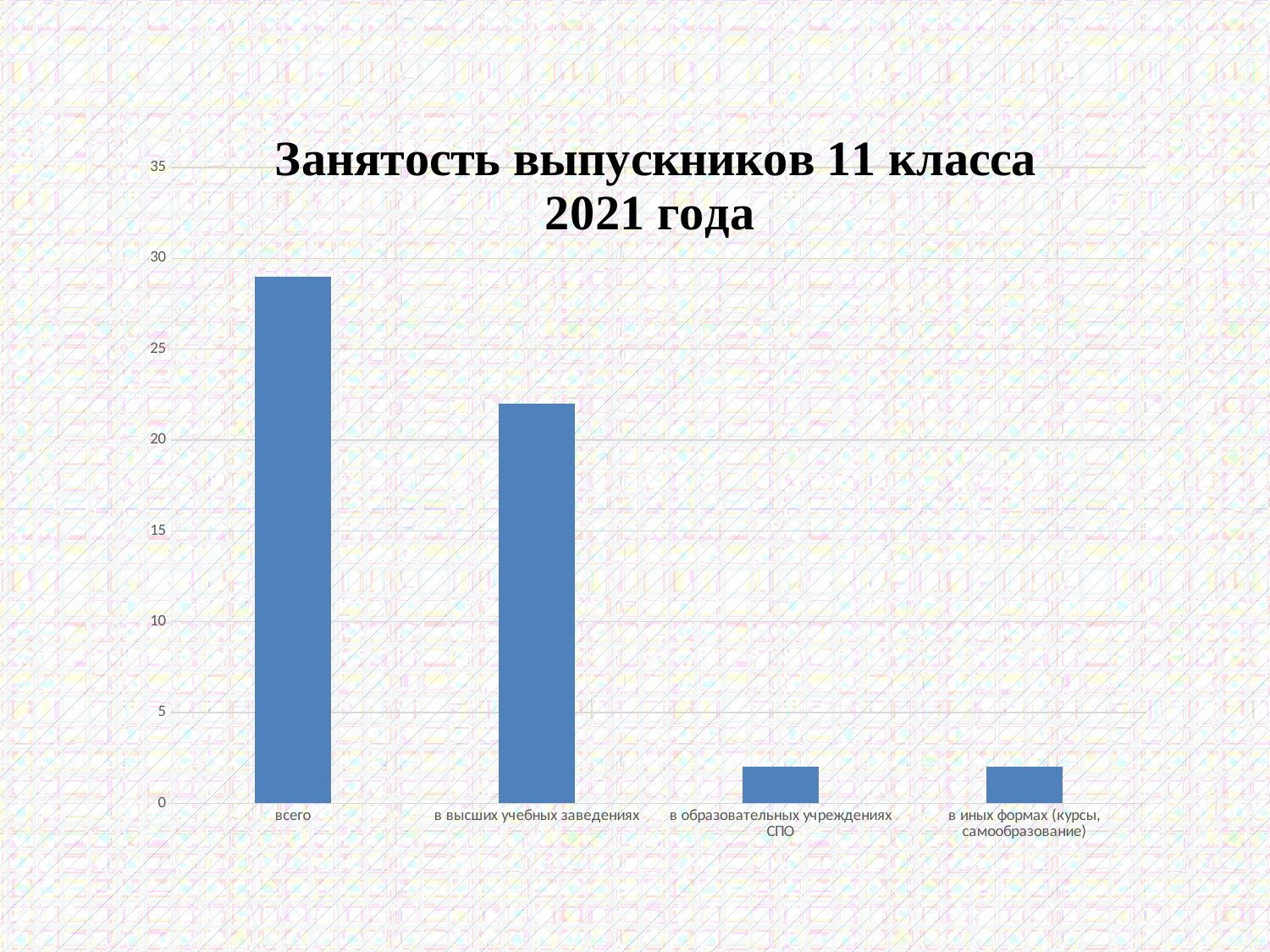
Which is larger: the value for "всего" or the value for "в высших учебных заведениях"? всего Is the value for "в иных формах (курсы, самообразование)" greater or less than 5? less Is the value for "всего" greater or less than 25? greater Which category has the highest bar? всего Is the value for "в образовательных учреждениях СПО" greater or less than 5? less What kind of chart is shown on the slide? bar chart Which is larger: the value for "в высших учебных заведениях" or the value for "в образовательных учреждениях СПО"? в высших учебных заведениях How many categories are shown on the x axis of the chart? 4 What is the title of the chart? Занятость выпускников 11 класса 2021 года